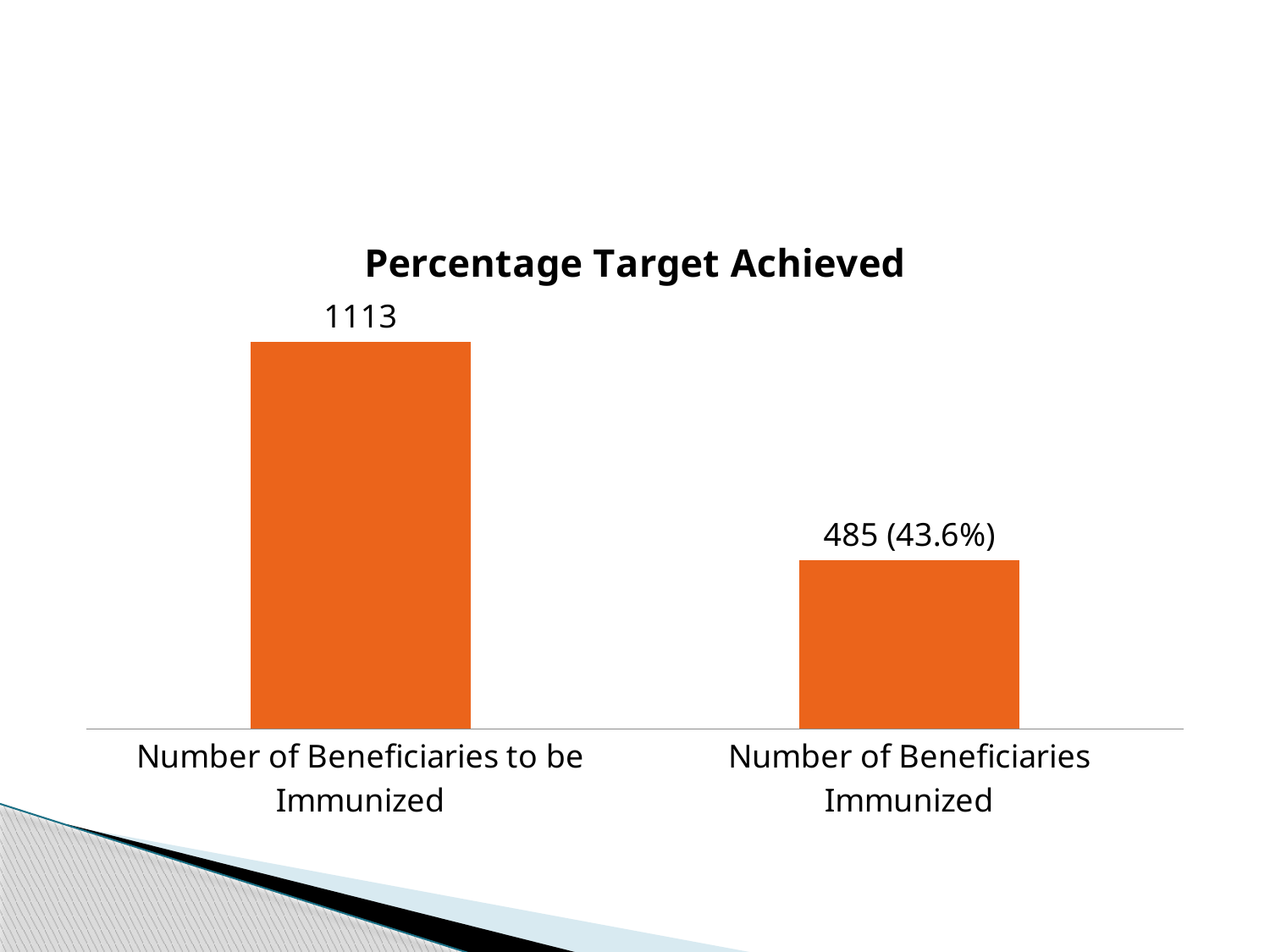
What is the data label shown for Number of Beneficiaries Immunized? 485 (43.6%) Which category has the lowest value? Number of Beneficiaries Immunized What is the difference between Number of Beneficiaries to be Immunized and Number of Beneficiaries Immunized? 628 Do the values rise or fall from left to right across the categories? Fall What colour are the bars in the chart? Orange What percentage of the target was achieved according to the data label? 43.6% What is the value for Number of Beneficiaries to be Immunized? 1113 How many categories are shown in the chart? 2 What kind of chart is shown on the slide? Bar chart Which category has the highest value? Number of Beneficiaries to be Immunized Which is larger: Number of Beneficiaries to be Immunized or Number of Beneficiaries Immunized? Number of Beneficiaries to be Immunized What is the title of the chart? Percentage Target Achieved